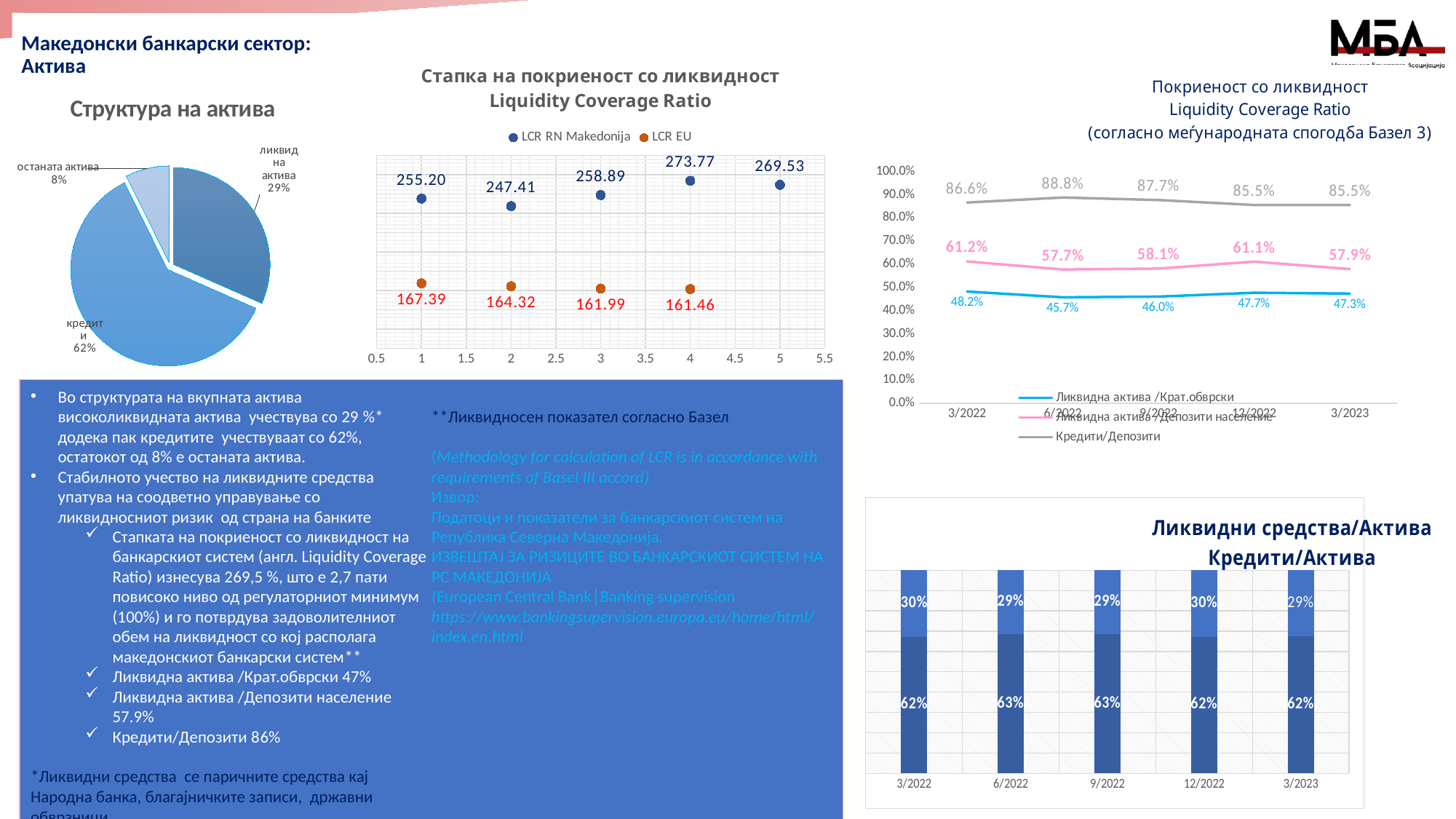
In the stacked bar chart 'Ликвидни средства/Актива Кредити/Актива', what is the value of the lower (dark blue) segment at 6/2022? 63% In the chart 'Стапка на покриеност со ликвидност Liquidity Coverage Ratio', what is the lowest value of the LCR EU series? 161.46 In the line chart 'Покриеност со ликвидност Liquidity Coverage Ratio (согласно меѓународната спогодба Базел 3)', what is the value of Ликвидна актива /Крат.обврски at 3/2023? 47.3% In the pie chart 'Структура на актива', which category has the smallest slice? останата актива In the line chart 'Покриеност со ликвидност Liquidity Coverage Ratio (согласно меѓународната спогодба Базел 3)', what is the value of Кредити/Депозити at 6/2022? 88.8% In the pie chart 'Структура на актива', what share of assets is 'кредити'? 62% In the chart 'Стапка на покриеност со ликвидност Liquidity Coverage Ratio', what is the difference between LCR RN Makedonija and LCR EU at x = 1? 87.81 In the pie chart 'Структура на актива', how many slices are there? 3 In the chart 'Стапка на покриеност со ликвидност Liquidity Coverage Ratio', how many series does the legend list? 2 What type of chart is 'Ликвидни средства/Актива Кредити/Актива'? stacked bar chart In the line chart 'Покриеност со ликвидност Liquidity Coverage Ratio (согласно меѓународната спогодба Базел 3)', which is larger at 12/2022: Ликвидна актива /Депозити население or Ликвидна актива /Крат.обврски? Ликвидна актива /Депозити население In the chart 'Стапка на покриеност со ликвидност Liquidity Coverage Ratio', what is the value of LCR RN Makedonija at x = 4? 273.77